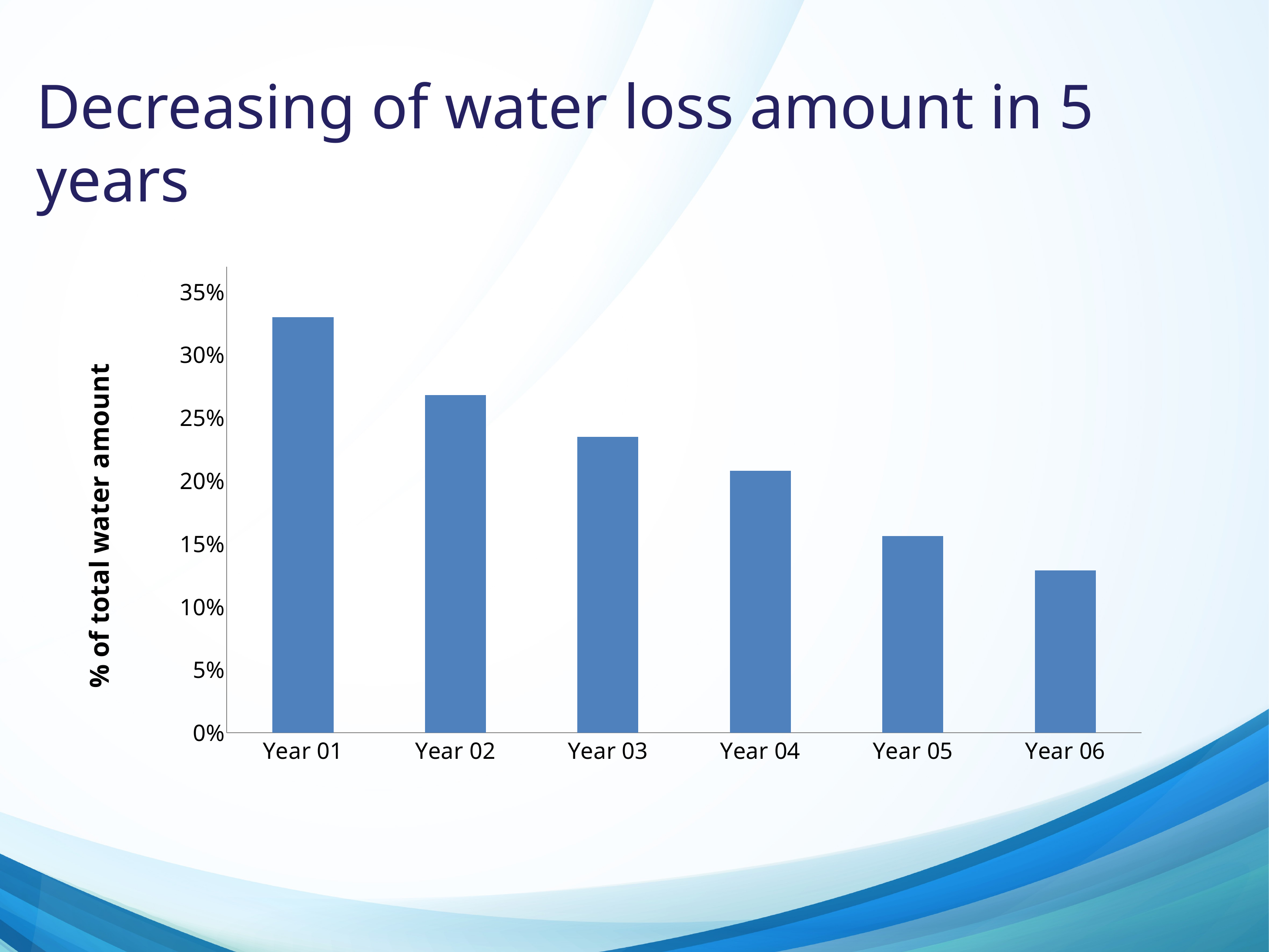
Is the value for Year 02 greater or less than 25%? greater Which year has the highest water loss percentage? Year 01 Is the value for Year 06 greater or less than 15%? less What is the label of the vertical axis? % of total water amount How many years are plotted on the x axis? 6 Is the value for Year 04 greater or less than 25%? less Which year has the lowest water loss percentage? Year 06 Do the values rise or fall from Year 01 to Year 06? fall What is the title of the slide? Decreasing of water loss amount in 5 years Which is larger, the value for Year 03 or the value for Year 05? Year 03 What kind of chart is shown on the slide? bar chart